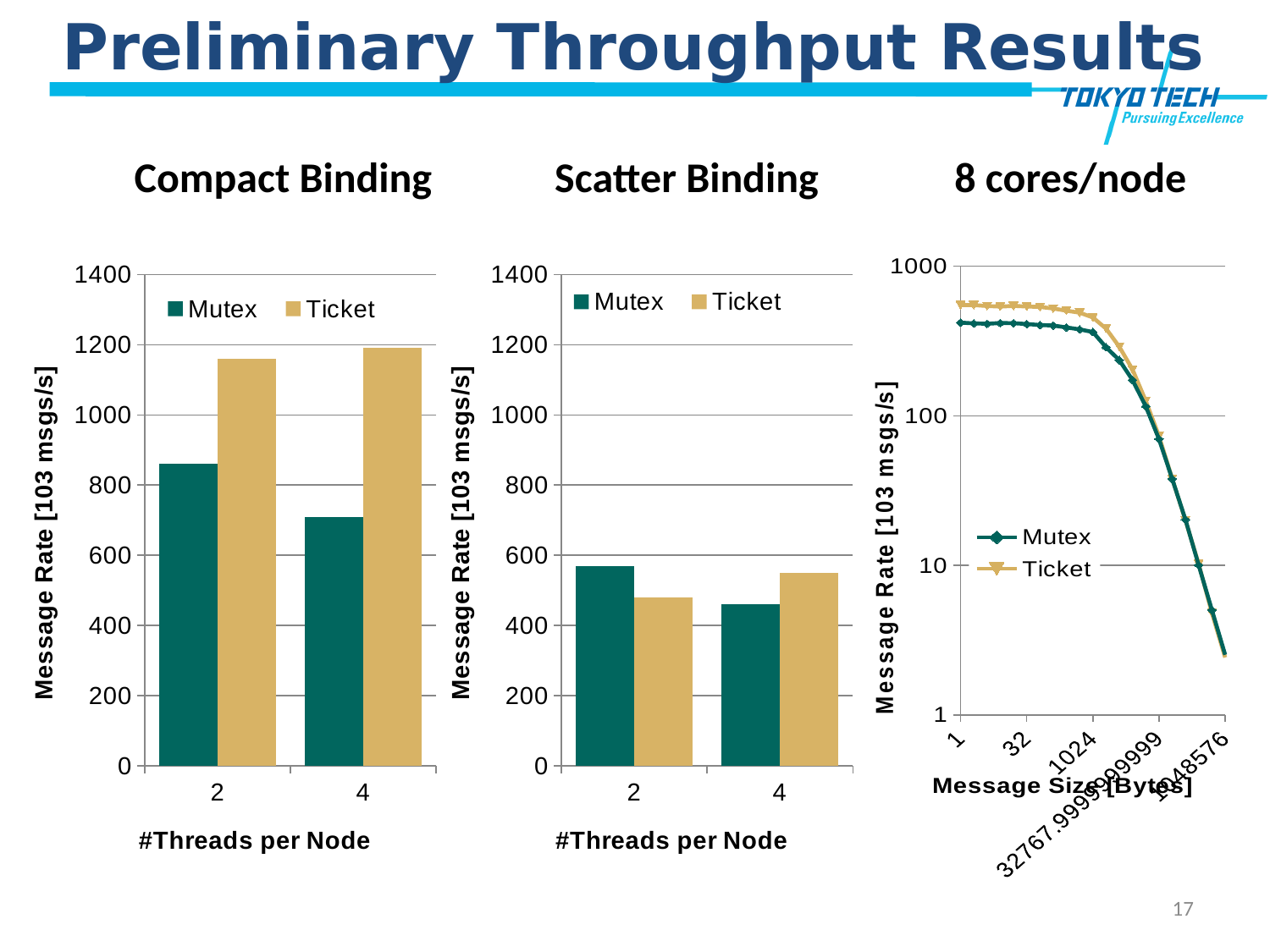
In the Scatter Binding chart, which is larger at 2 threads per node, Mutex or Ticket? Mutex In the Scatter Binding chart, which is larger at 4 threads per node, Mutex or Ticket? Ticket In the Compact Binding chart, which bar is the lowest? Mutex at 4 threads per node In the Scatter Binding chart, is the value for Ticket at 2 threads per node greater or less than 600? less In the 8 cores/node chart, which series is higher at a message size of 1 byte, Mutex or Ticket? Ticket In the Compact Binding chart, is the value for Ticket at 2 threads per node greater or less than 1000? greater In the Compact Binding chart, is the value for Mutex at 2 threads per node greater or less than 800? greater What kind of chart is the 8 cores/node chart? line chart In the 8 cores/node chart, do the message rates rise or fall as message size increases? fall How many series does the legend of the Scatter Binding chart list? 2